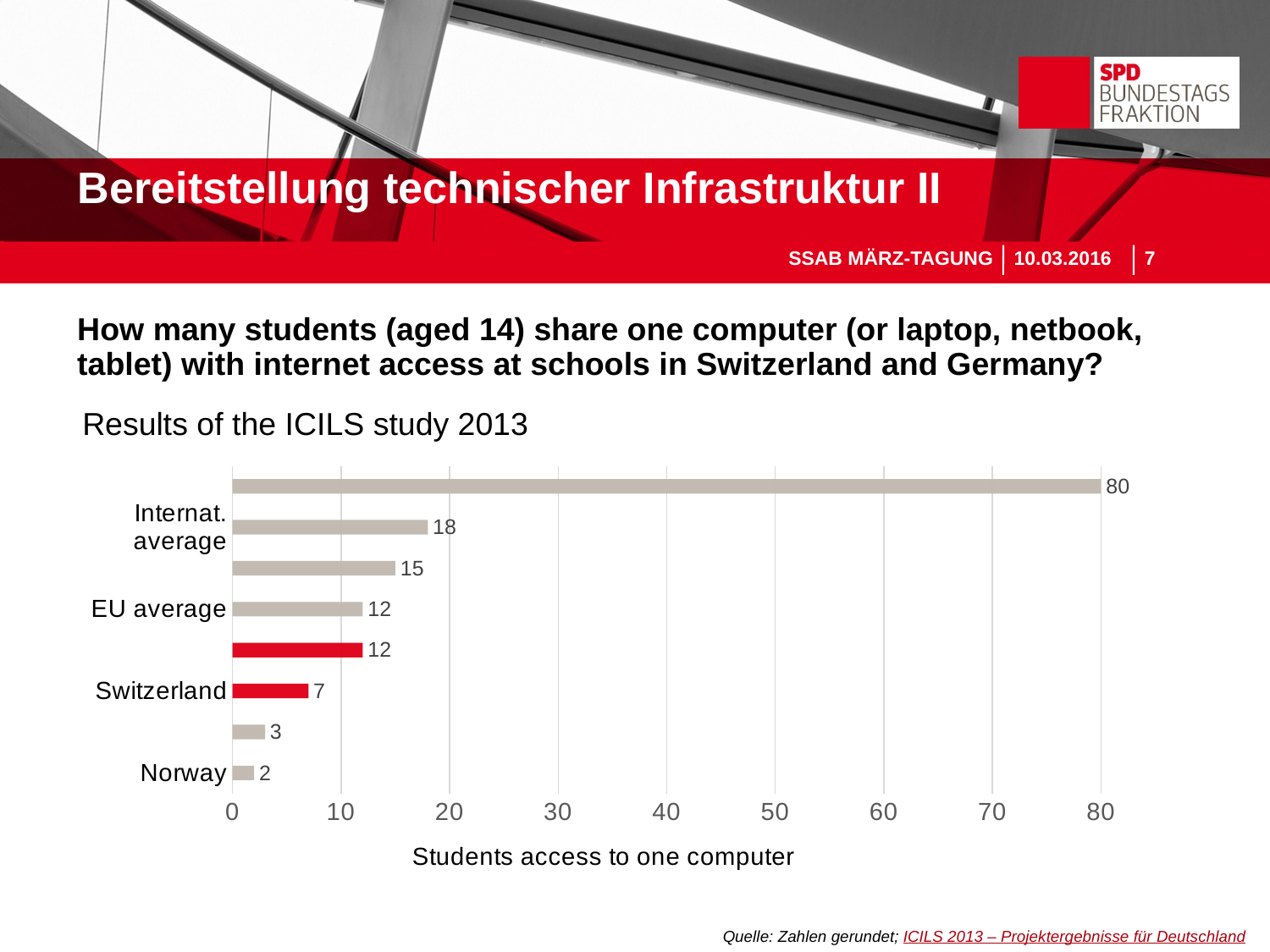
What is the difference between Switzerland and Norway? 5 What is the title of the x axis? Students access to one computer What is the value for Norway? 2 What is the value for the Internat. average? 18 How many bars are plotted in the chart? 8 What kind of chart is shown on the slide? bar chart What is the value for the EU average? 12 Which is larger, the value for Switzerland or the value for Norway? Switzerland What is the difference between the Internat. average and the EU average? 6 Is the value for the Internat. average greater or less than 20? less Which labelled category has the lowest value? Norway What is the value for Switzerland? 7